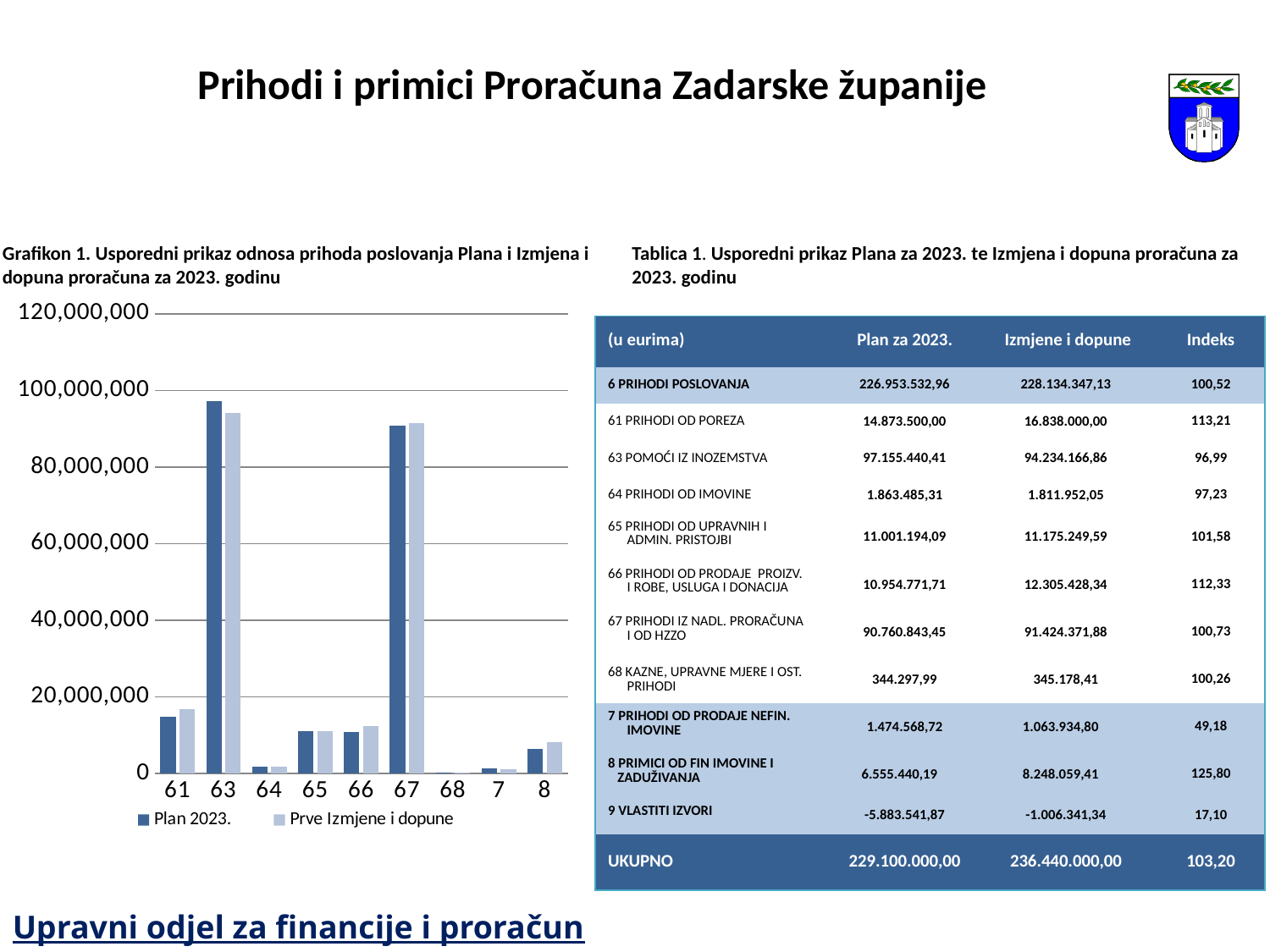
How many series does the legend of Grafikon 1 list? 2 In Grafikon 1, is the Prve Izmjene i dopune value for category 67 greater or less than 80,000,000? greater In Grafikon 1, for category 8, which series has the larger bar: Plan 2023. or Prve Izmjene i dopune? Prve Izmjene i dopune In Grafikon 1, is the Plan 2023. value for category 61 greater or less than 20,000,000? less In Grafikon 1, which category has the lowest bars for both series? 68 In Grafikon 1, for category 61, which series has the larger bar: Plan 2023. or Prve Izmjene i dopune? Prve Izmjene i dopune What are the two legend entries of Grafikon 1? Plan 2023. and Prve Izmjene i dopune In Grafikon 1, which category has the highest Plan 2023. bar? 63 In Grafikon 1, for category 63, which series has the larger bar: Plan 2023. or Prve Izmjene i dopune? Plan 2023. How many categories are shown on the x axis of Grafikon 1? 9 What kind of chart is Grafikon 1 on the slide? bar chart In Grafikon 1, is the Plan 2023. value for category 63 greater or less than 80,000,000? greater